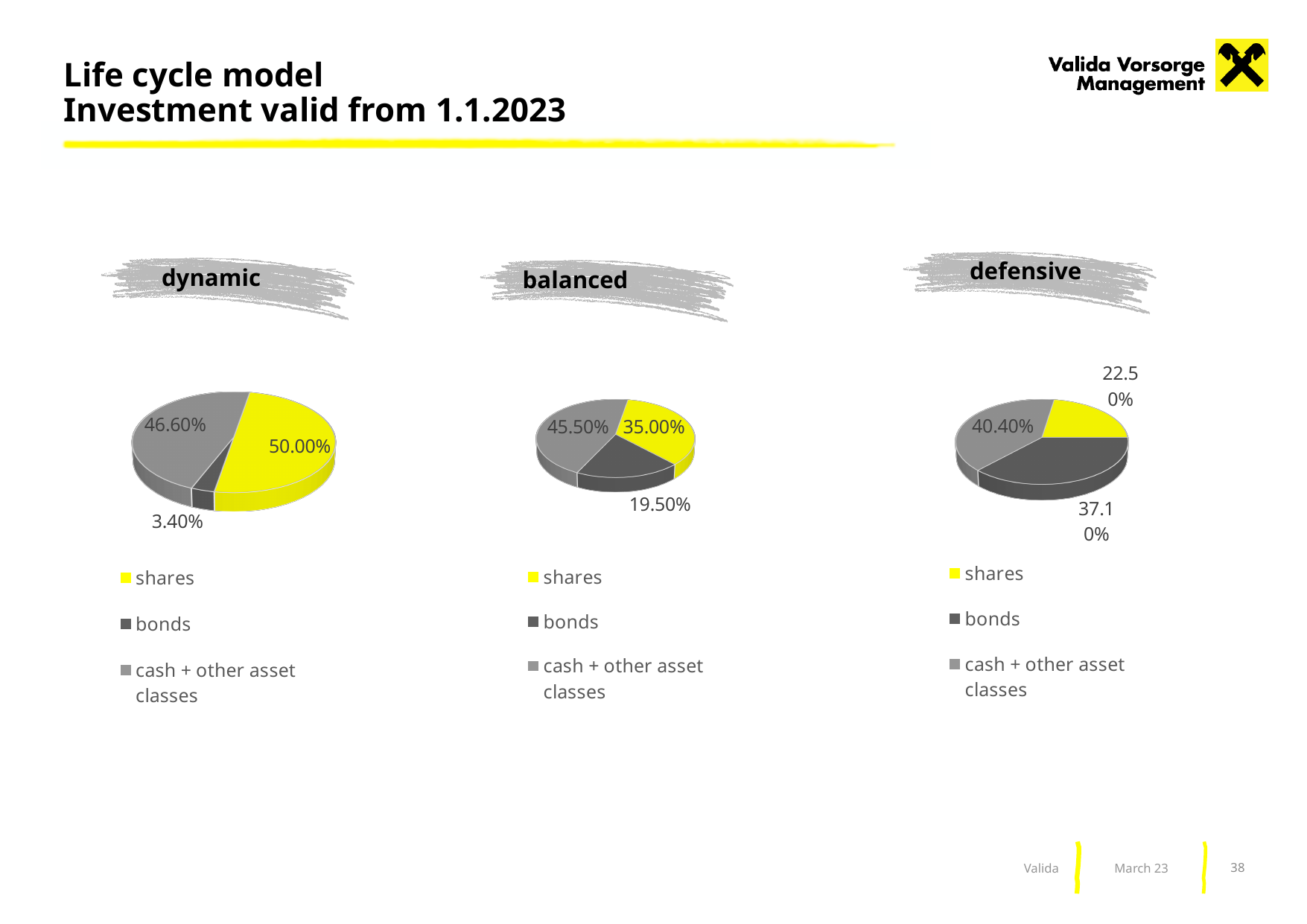
In the dynamic pie chart, what share is allocated to shares? 50.00% In the balanced pie chart, what is the value for bonds? 19.50% In the balanced pie chart, what is the difference between the shares slice and the bonds slice? 15.50% In the balanced pie chart, which category has the largest slice? cash + other asset classes In the dynamic pie chart, which category has the smallest slice? bonds How many entries does the legend of the defensive chart list? 3 In the dynamic pie chart, which is larger: shares or cash + other asset classes? shares What type of chart is used for the dynamic, balanced and defensive models? pie chart In the balanced pie chart, what is the value for cash + other asset classes? 45.50% How many slices does the balanced pie chart have? 3 In the dynamic pie chart, what is the value for bonds? 3.40% In the defensive pie chart, what is the value for cash + other asset classes? 40.40%